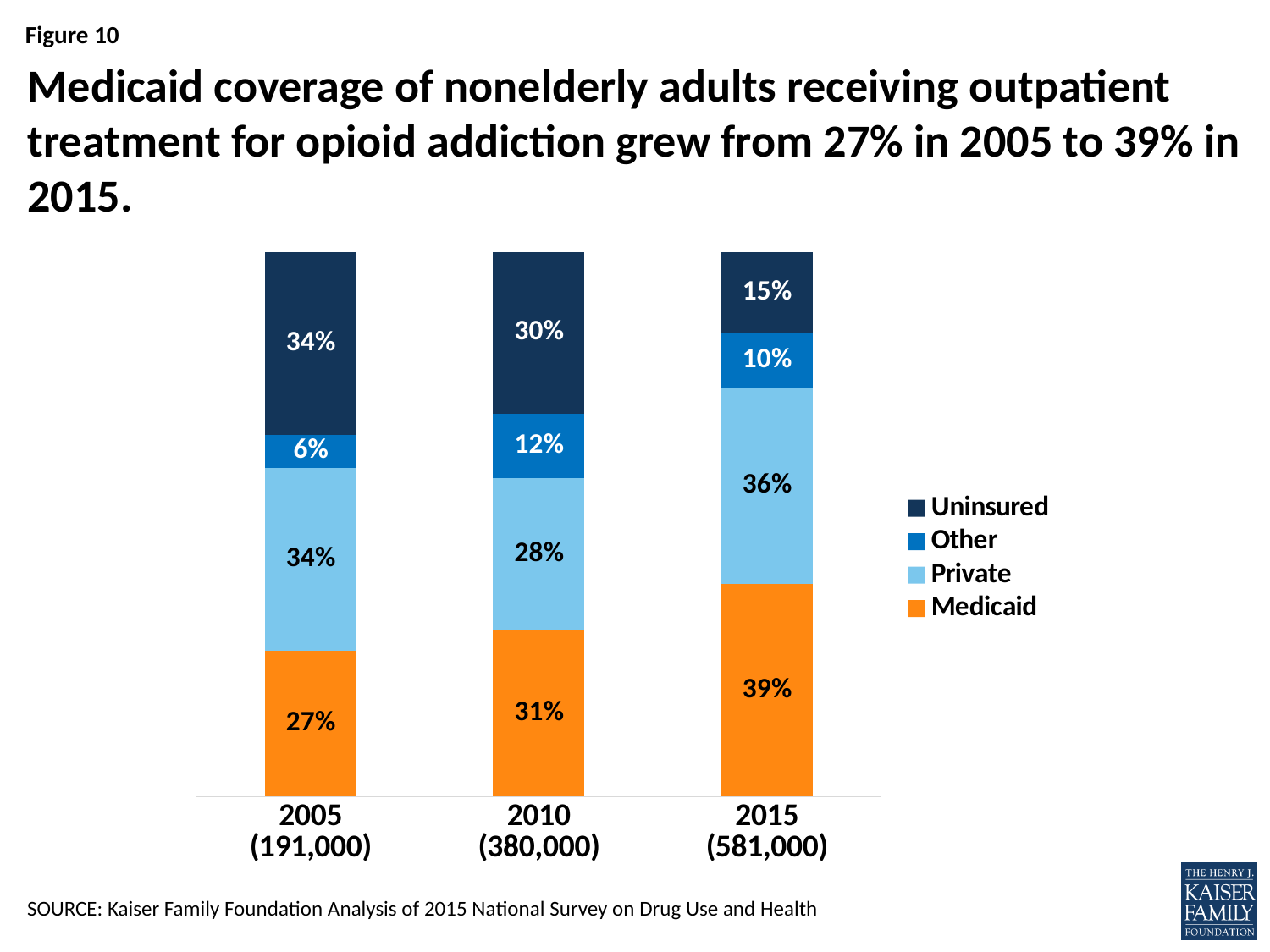
In which year was the Uninsured share lowest? 2015 In which year was the Medicaid share highest? 2015 How many series does the legend list? 4 What was the Other coverage share in 2015? 10% By how many percentage points did the Medicaid share grow from 2005 to 2015? 12 percentage points Which was larger in 2010, the Medicaid share or the Uninsured share? Medicaid What kind of chart is shown? Stacked bar chart Does the Uninsured share rise or fall from 2005 to 2015? Fall What was the Uninsured share in 2005? 34% What share of nonelderly adults receiving outpatient opioid treatment had Medicaid coverage in 2015? 39% What was the Private coverage share in 2010? 28% How many years are shown on the x axis? 3